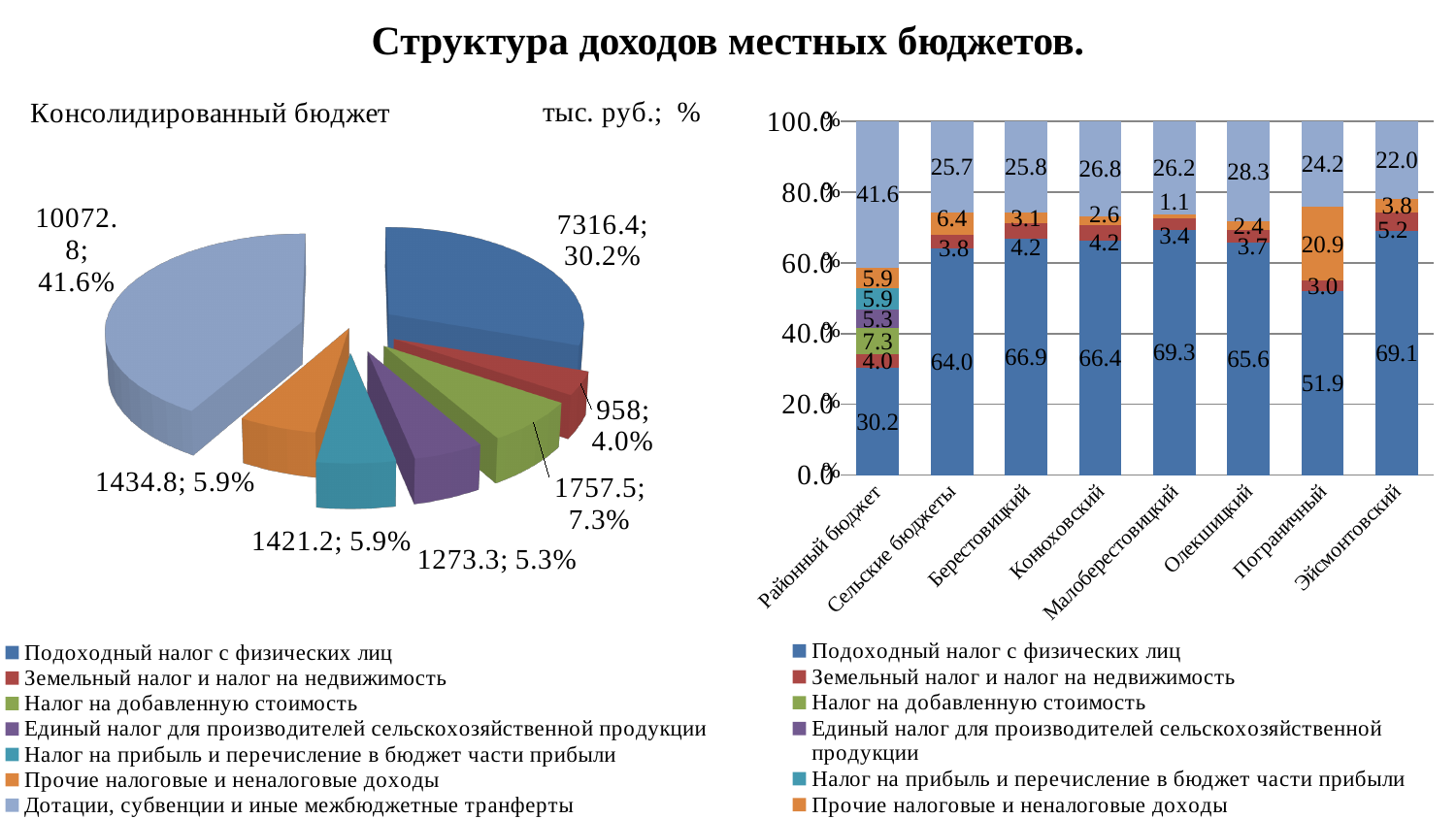
In the stacked bar chart on the right, what is the value of 'Прочие налоговые и неналоговые доходы' for 'Пограничный'? 20.9 In the pie chart 'Консолидированный бюджет', what value is shown for 'Дотации, субвенции и иные межбюджетные трансферты'? 10072.8; 41.6% In the pie chart 'Консолидированный бюджет', what share does 'Подоходный налог с физических лиц' have? 30.2% What kind of chart is the chart on the left of the slide? Pie chart How many entries does the legend of the pie chart 'Консолидированный бюджет' list? 7 In the pie chart 'Консолидированный бюджет', which category has the largest slice? Дотации, субвенции и иные межбюджетные трансферты In the stacked bar chart on the right, what is the difference between the 'Подоходный налог с физических лиц' values for 'Сельские бюджеты' and 'Районный бюджет'? 33.8 How many categories are shown on the x axis of the stacked bar chart on the right? 8 In the stacked bar chart on the right, which category has the lowest value for 'Подоходный налог с физических лиц'? Районный бюджет In the pie chart 'Консолидированный бюджет', which category has the smallest slice? Земельный налог и налог на недвижимость In the stacked bar chart on the right, which has the larger value for 'Подоходный налог с физических лиц': 'Олекшицкий' or 'Пограничный'? Олекшицкий In the stacked bar chart on the right, what is the value of 'Подоходный налог с физических лиц' for 'Пограничный'? 51.9